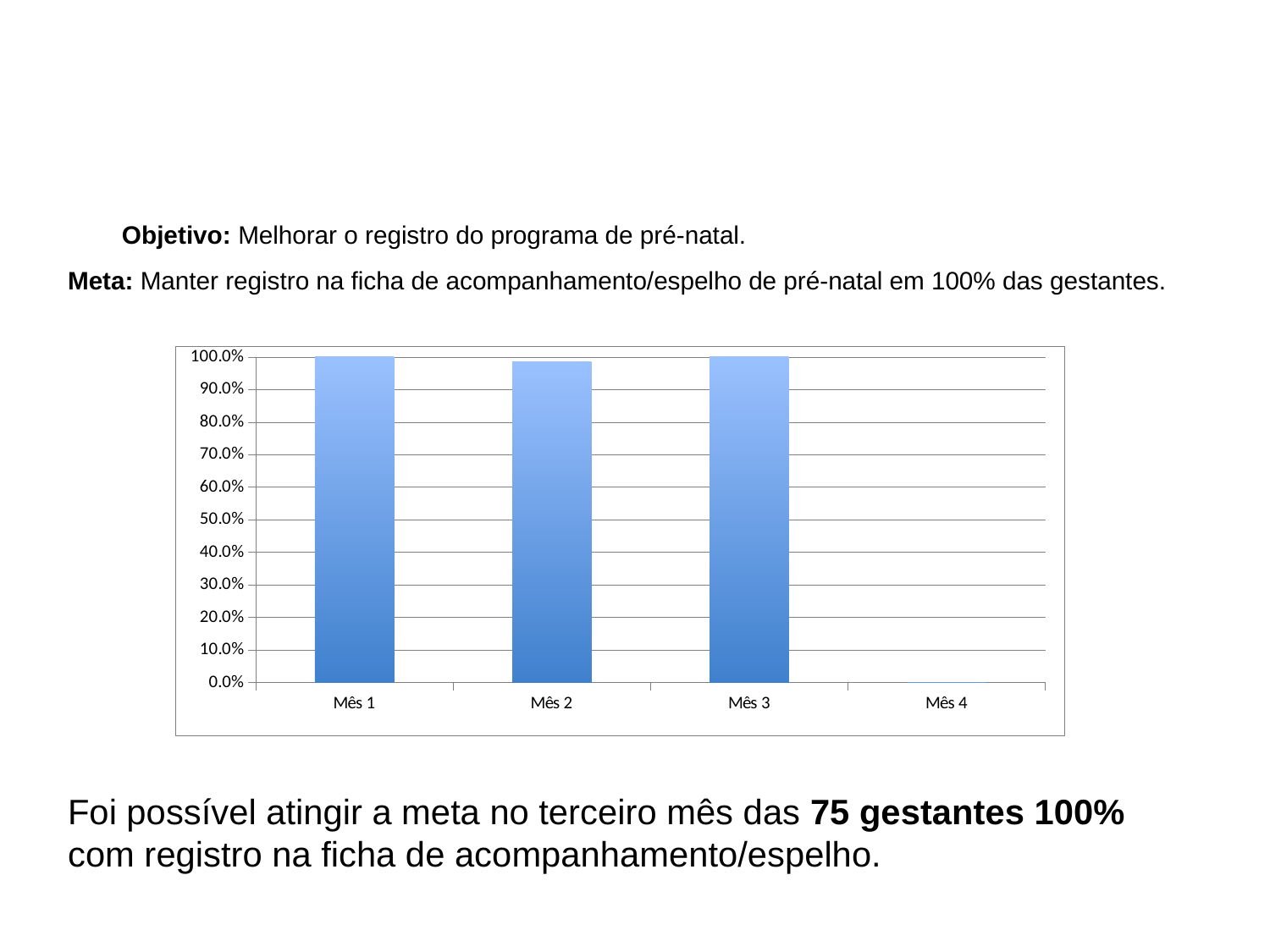
What is the label of the first category on the x axis of the chart? Mês 1 Is the value for Mês 2 greater or less than 90.0%? greater Is the value for Mês 4 greater or less than 10.0%? less Which is larger, the value for Mês 1 or the value for Mês 4? Mês 1 What kind of chart is shown on the slide? bar chart What is the highest tick label shown on the y axis of the chart? 100.0% Does the value rise or fall from Mês 3 to Mês 4? fall What is the value for Mês 3 in the chart? 100.0% How many categories are shown on the x axis of the chart? 4 What is the value for Mês 1 in the chart? 100.0% What is the value for Mês 4 in the chart? 0.0% Which category has the lowest value in the chart? Mês 4